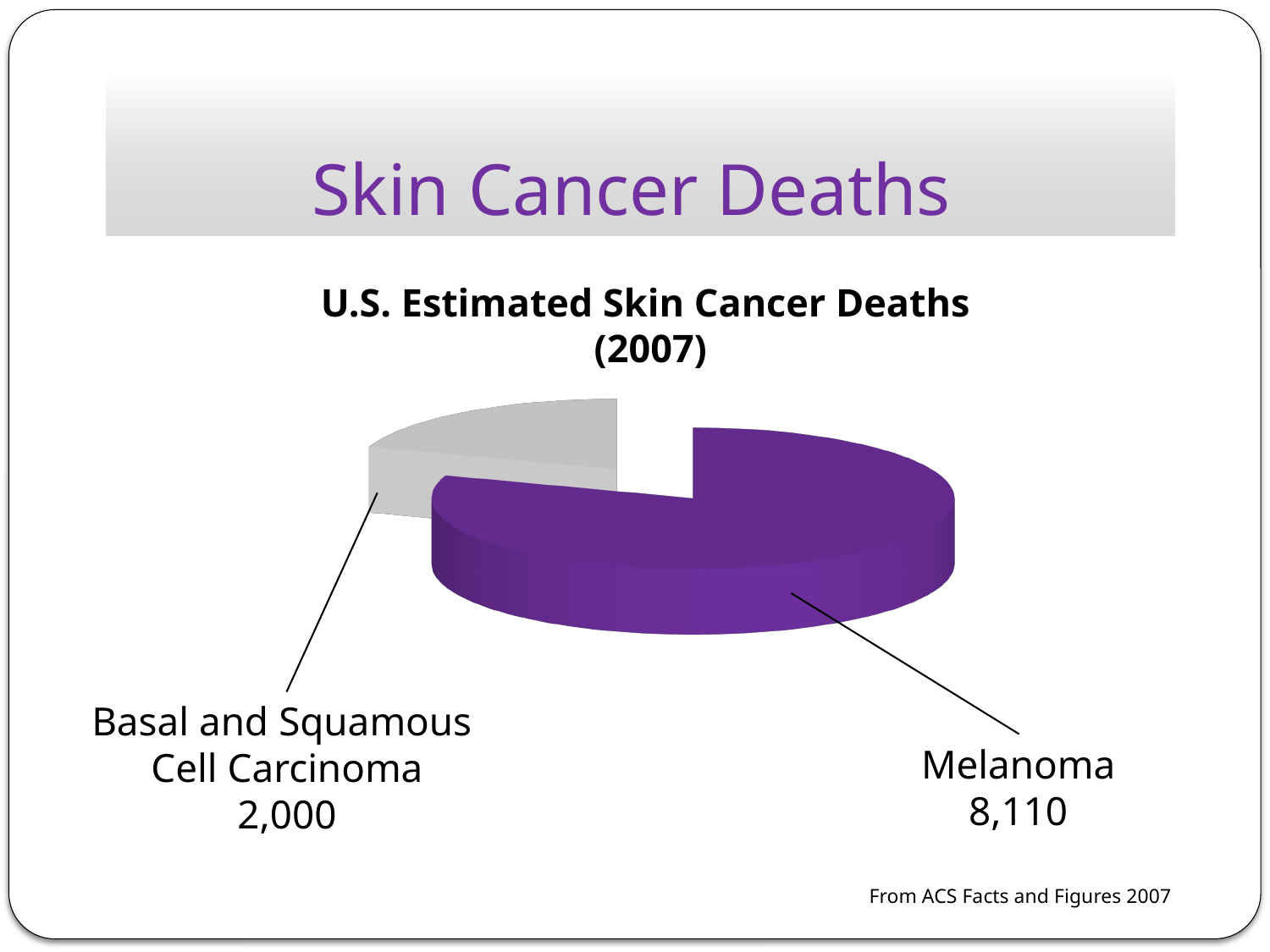
What kind of chart is shown on the slide? pie chart Which has more estimated deaths, Melanoma or Basal and Squamous Cell Carcinoma? Melanoma What share of the total deaths does Melanoma represent? 80.2% What is the total number of estimated skin cancer deaths shown in the chart? 10,110 How many estimated deaths are attributed to Melanoma? 8,110 What is the title of the chart? U.S. Estimated Skin Cancer Deaths (2007) What colour is the Melanoma slice of the pie? purple Which category accounts for the smallest slice of the pie? Basal and Squamous Cell Carcinoma How many slices does the pie chart have? 2 Which category accounts for the largest slice of the pie? Melanoma What is the difference between the Melanoma deaths and the Basal and Squamous Cell Carcinoma deaths? 6,110 How many estimated deaths are attributed to Basal and Squamous Cell Carcinoma? 2,000